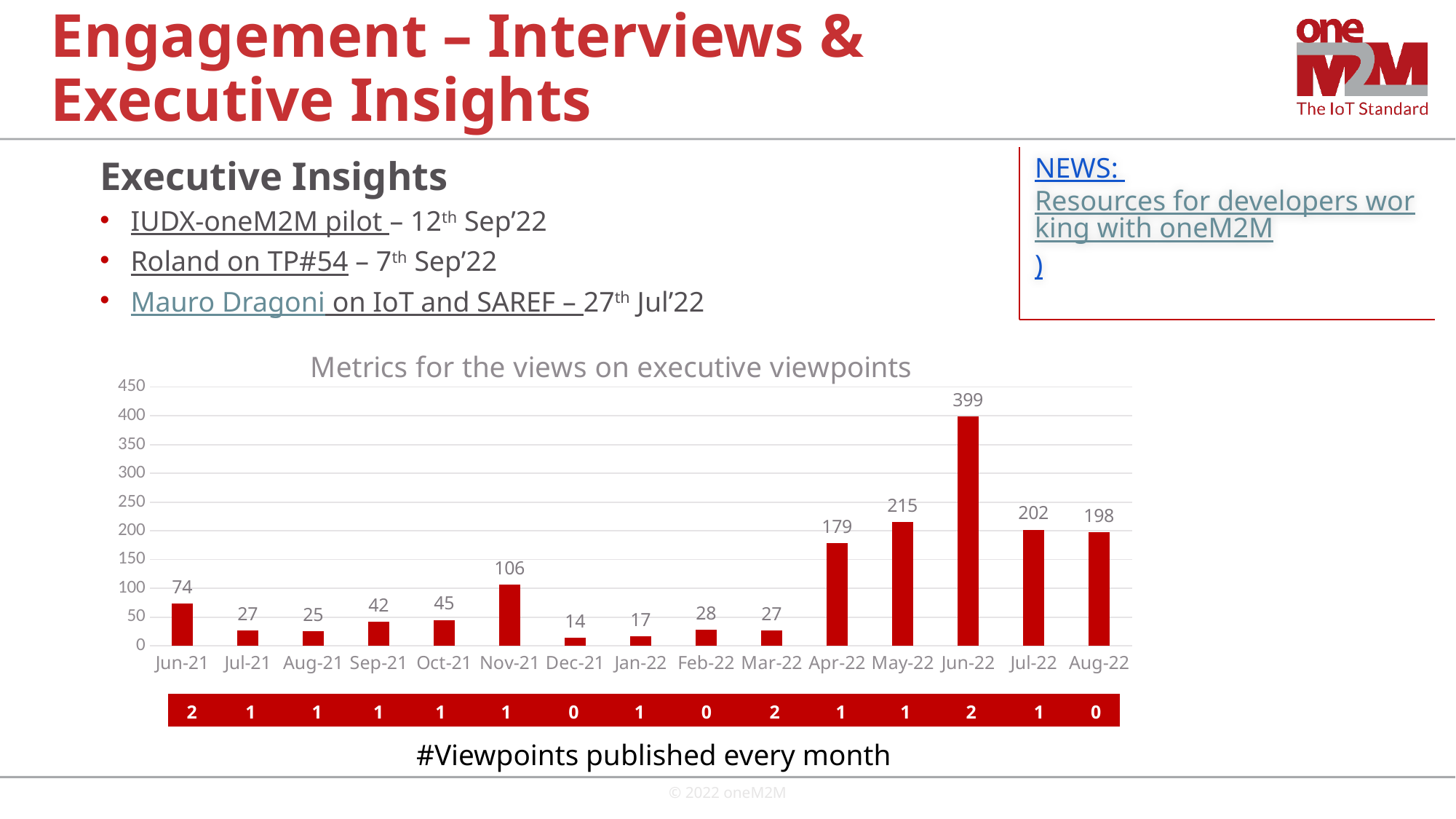
What is the difference between the values for Jun-21 and Jul-21? 47 Which month has the highest value in the chart? Jun-22 Is the value for Jun-22 greater or less than 350? greater What is the title of the chart? Metrics for the views on executive viewpoints What is the value for Nov-21 in the chart? 106 Which month has the lowest value in the chart? Dec-21 What is the value for Apr-22 in the chart? 179 Which is larger, the value for Jul-22 or the value for Aug-22? Jul-22 What kind of chart is shown on the slide? bar chart What is the value for Jun-22 in the chart? 399 How many months are shown on the x axis of the chart? 15 What is the difference between the values for Jun-22 and May-22? 184